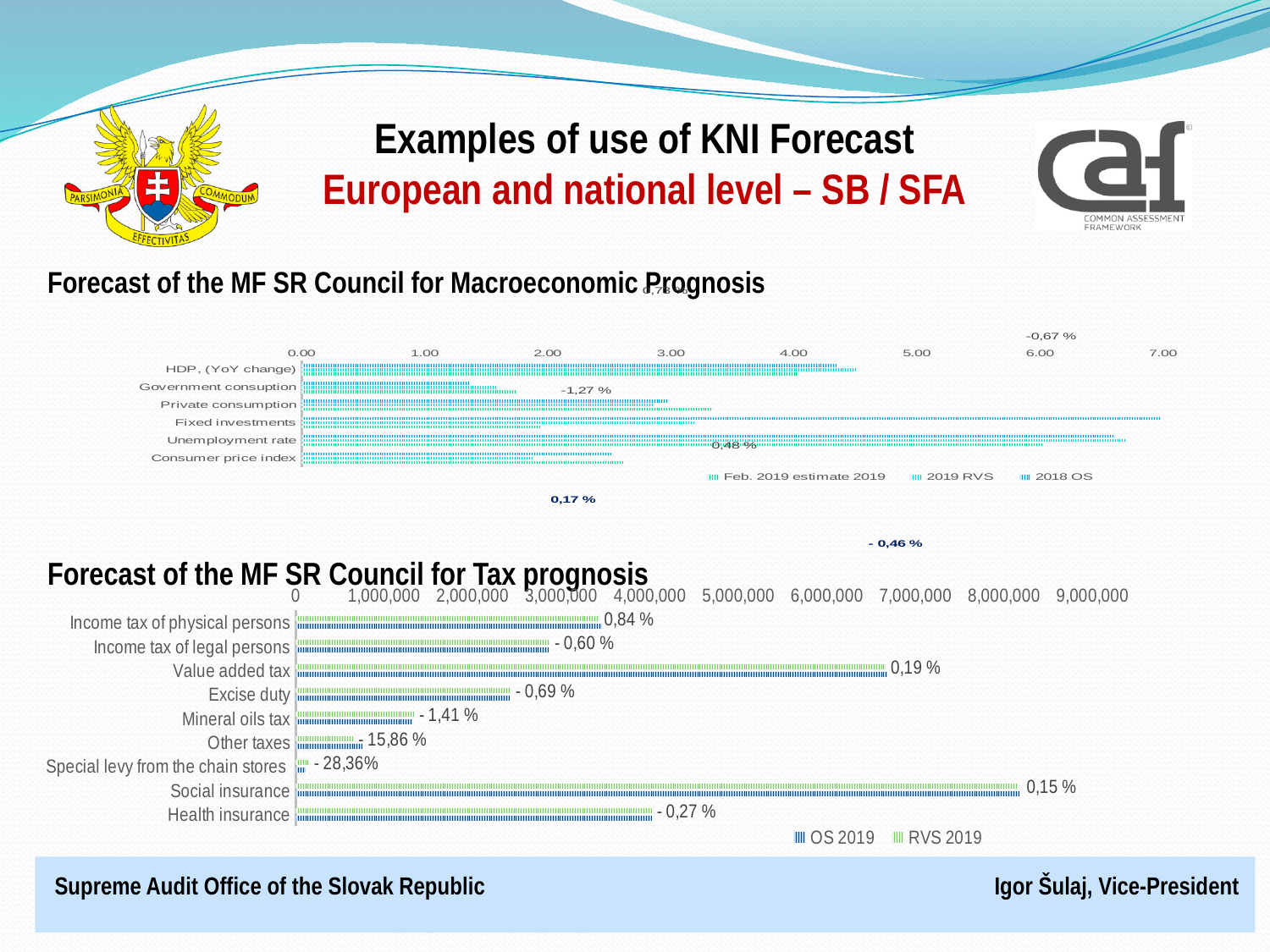
How many series does the legend of the 'Forecast of the MF SR Council for Macroeconomic Prognosis' chart list? 3 How many categories are shown in the 'Forecast of the MF SR Council for Tax prognosis' chart? 9 What kind of chart is the 'Forecast of the MF SR Council for Tax prognosis' chart? bar chart In the 'Forecast of the MF SR Council for Tax prognosis' chart, is the value for Mineral oils tax greater or less than 2,000,000? less In the 'Forecast of the MF SR Council for Tax prognosis' chart, which category has the shortest bars? Special levy from the chain stores In the 'Forecast of the MF SR Council for Tax prognosis' chart, which is larger, Value added tax or Excise duty? Value added tax In the 'Forecast of the MF SR Council for Tax prognosis' chart, which category has the longest bars? Social insurance How many categories are shown in the 'Forecast of the MF SR Council for Macroeconomic Prognosis' chart? 6 In the 'Forecast of the MF SR Council for Tax prognosis' chart, is the value for Social insurance greater or less than 7,000,000? greater What are the two legend entries of the 'Forecast of the MF SR Council for Tax prognosis' chart? OS 2019 and RVS 2019 How many series does the legend of the 'Forecast of the MF SR Council for Tax prognosis' chart list? 2 In the 'Forecast of the MF SR Council for Macroeconomic Prognosis' chart, is the value for Government consumption greater or less than 2.00? less